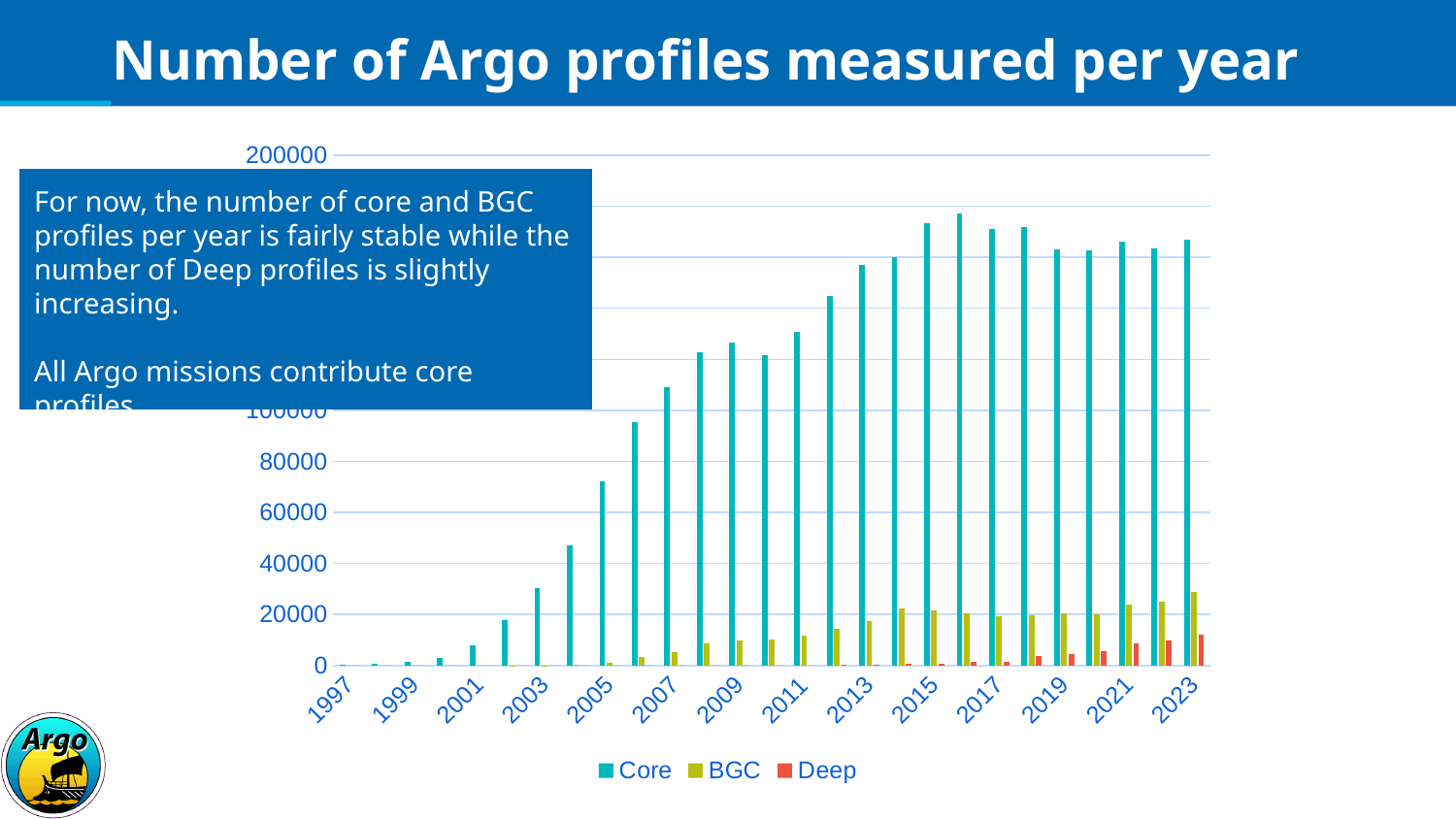
What is the title of the chart? Number of Argo profiles measured per year Is the Core value for 2005 greater or less than 60000? greater Do the Core values rise or fall from 1997 to 2013? rise Is the BGC value for 2023 greater or less than 20000? greater Which is larger in 2023, the BGC value or the Deep value? BGC What are the three series named in the legend? Core, BGC, Deep Is the Core value for 2009 greater or less than 100000? greater What kind of chart is shown on the slide? bar chart Which series has the highest value in 2023? Core Which series has the lowest value in 2023? Deep How many series does the legend list? 3